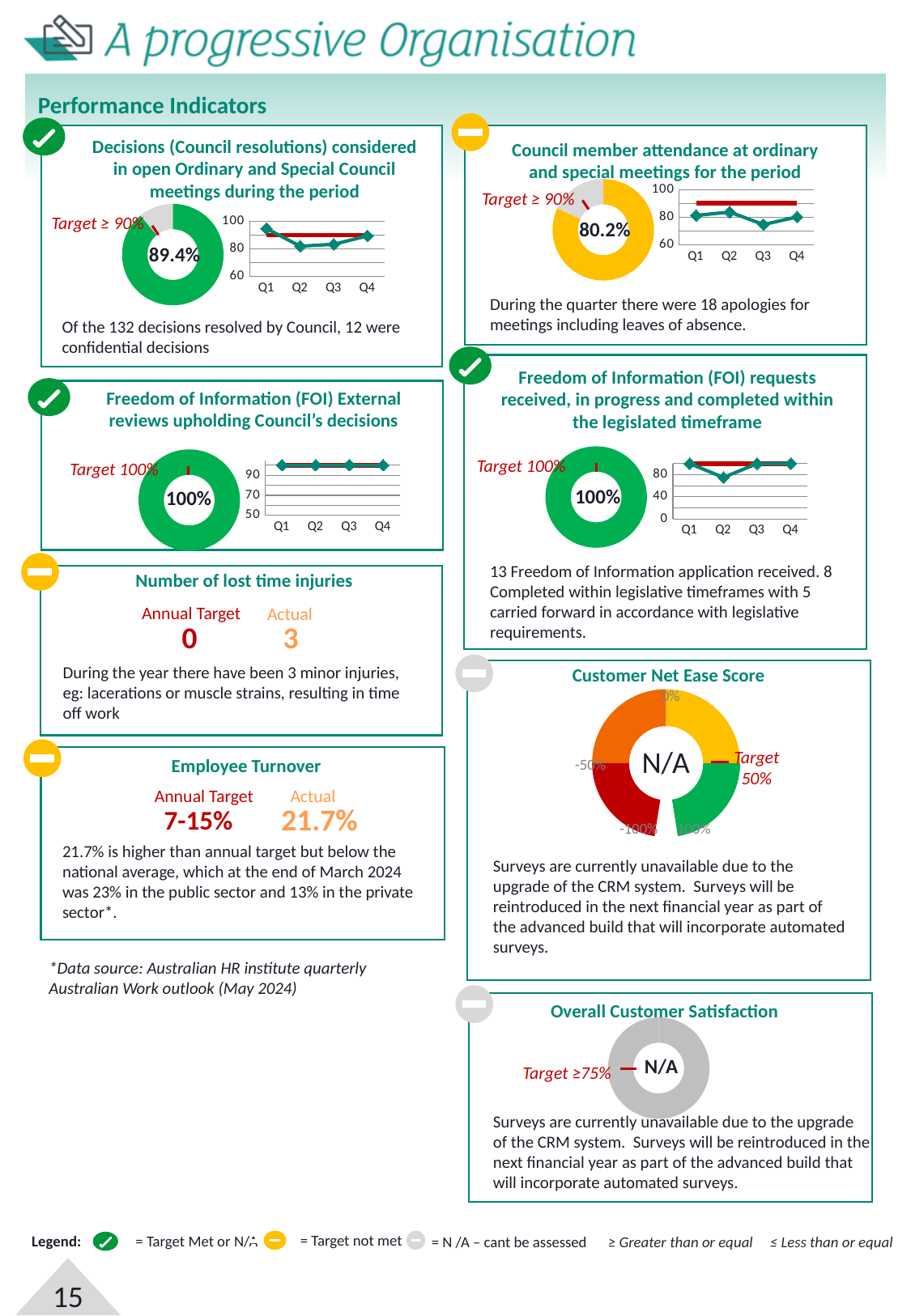
What kind of chart shows the quarterly values next to the donut in the 'Decisions (Council resolutions) considered in open Ordinary and Special Council meetings' panel? line chart On the 'Freedom of Information (FOI) External reviews upholding Council's decisions' line chart, do the values rise, fall or stay flat from Q1 to Q4? stay flat Which is larger: the donut value for 'Decisions (Council resolutions) considered in open Ordinary and Special Council meetings' or the donut value for 'Council member attendance at ordinary and special meetings'? Decisions (Council resolutions) considered in open Ordinary and Special Council meetings On the 'Decisions (Council resolutions) considered in open Ordinary and Special Council meetings' line chart, which quarter has the highest value? Q1 On the 'Council member attendance at ordinary and special meetings for the period' line chart, is the value for Q3 greater or less than 80? less On the 'Council member attendance at ordinary and special meetings for the period' line chart, which quarter has the lowest value? Q3 How many quarters are plotted on the 'Council member attendance at ordinary and special meetings for the period' line chart? 4 On the 'Decisions (Council resolutions) considered in open Ordinary and Special Council meetings during the period' chart, what percentage is shown in the centre of the donut? 89.4% On the 'Council member attendance at ordinary and special meetings for the period' chart, what percentage is shown in the centre of the donut? 80.2% What target is shown on the 'Overall Customer Satisfaction' chart? Target ≥75% What is the difference between the donut value for 'Decisions (Council resolutions) considered' (89.4%) and the donut value for 'Council member attendance' (80.2%)? 9.2 percentage points On the 'Freedom of Information (FOI) requests received, in progress and completed within the legislated timeframe' line chart, which quarter has the lowest value? Q2